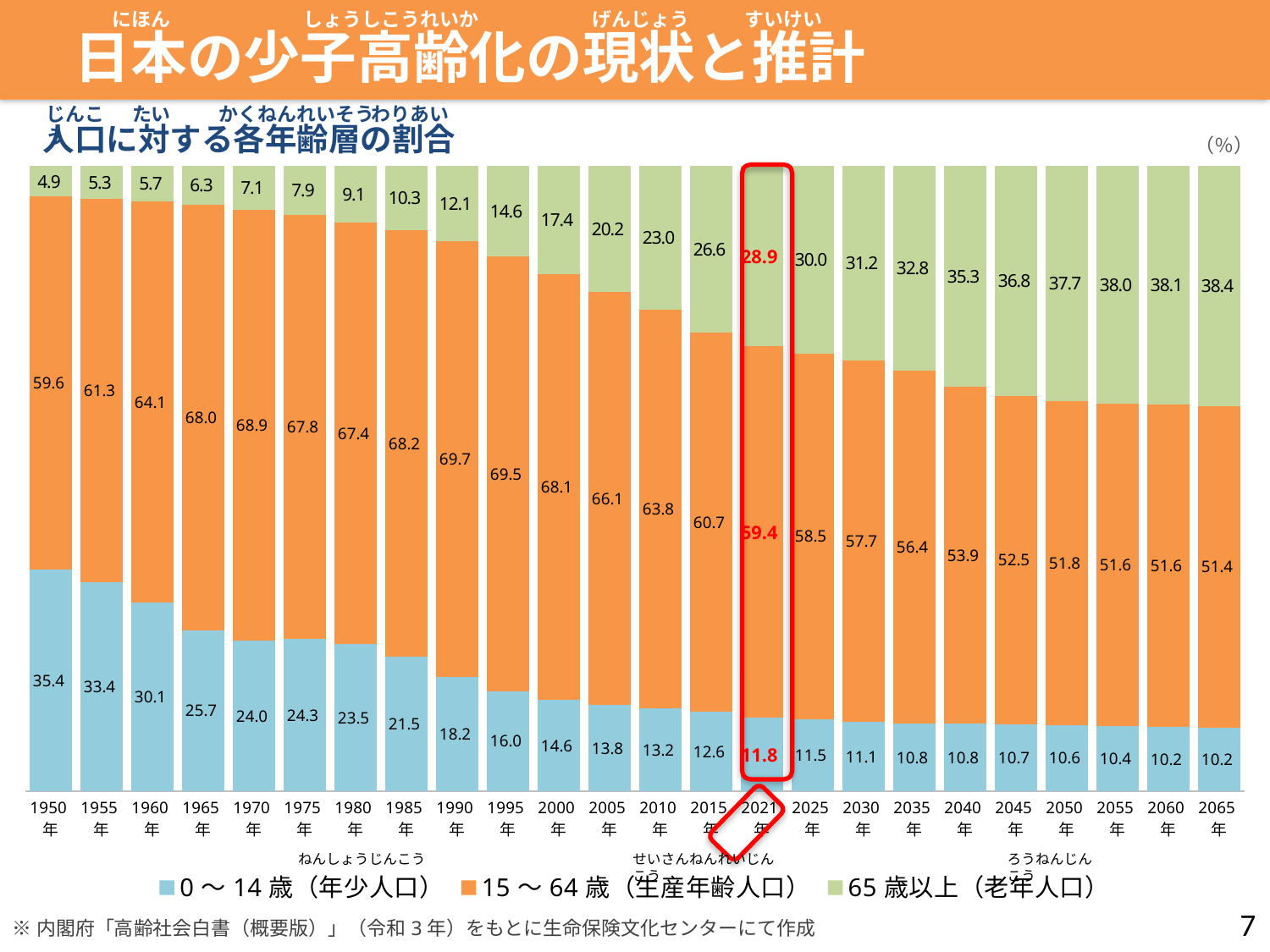
How many years (bars) are shown on the x axis? 24 What is the share of the population aged 15–64 (15～64歳) in 2065? 51.4 Does the share of the population aged 65 and over rise or fall from 1950 to 2065? Rise What kind of chart is shown on the slide? Stacked bar chart What is the share of the population aged 0–14 (0～14歳) in 1950? 35.4 How many series does the legend list? 3 By how many percentage points does the 65 and over share in 2065 exceed that in 1950? 33.5 By how many percentage points is the 0–14 share in 1950 larger than in 2021? 23.6 Which year has a larger share of the 15–64 age group, 2000 or 2010? 2000年 What is the share of the population aged 65 and over (65歳以上) in 2021? 28.9 In which year is the share of the 65 and over age group the lowest? 1950年 In which year is the share of the 15–64 age group the highest? 1990年